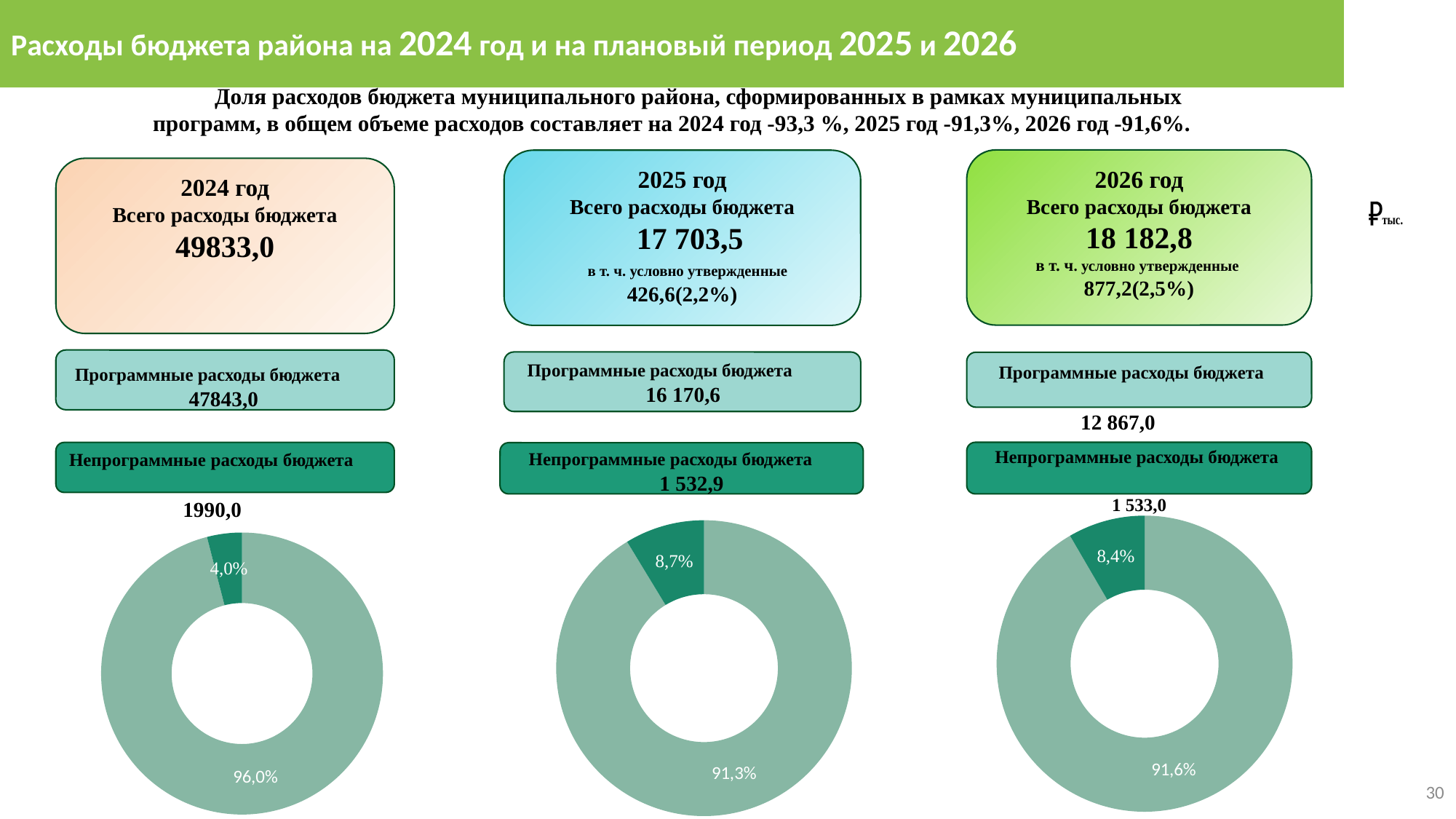
In the right donut chart (2026), what percentage is shown for the large light-green slice? 91,6% Which year's donut chart shows the largest dark-green (non-program) slice: 2024, 2025 or 2026? 2025 How many slices does each donut chart on the slide have? 2 In the middle donut chart (2025), what percentage is shown for the large light-green slice? 91,3% In the middle donut chart (2025), what percentage is shown for the small dark-green slice? 8,7% In the right donut chart (2026), what percentage is shown for the small dark-green slice? 8,4% In the left donut chart (2024), what is the difference in percentage points between the large slice and the small slice? 92,0 Is the light-green slice in the middle donut chart (2025) larger or smaller than the light-green slice in the left donut chart (2024)? Smaller In the left donut chart (2024), what percentage is shown for the large light-green slice? 96,0% Which year's donut chart shows the smallest dark-green (non-program) slice: 2024, 2025 or 2026? 2024 In the left donut chart (2024), what percentage is shown for the small dark-green slice? 4,0% What kind of chart is shown under the 2024 column on the left? Donut (pie) chart